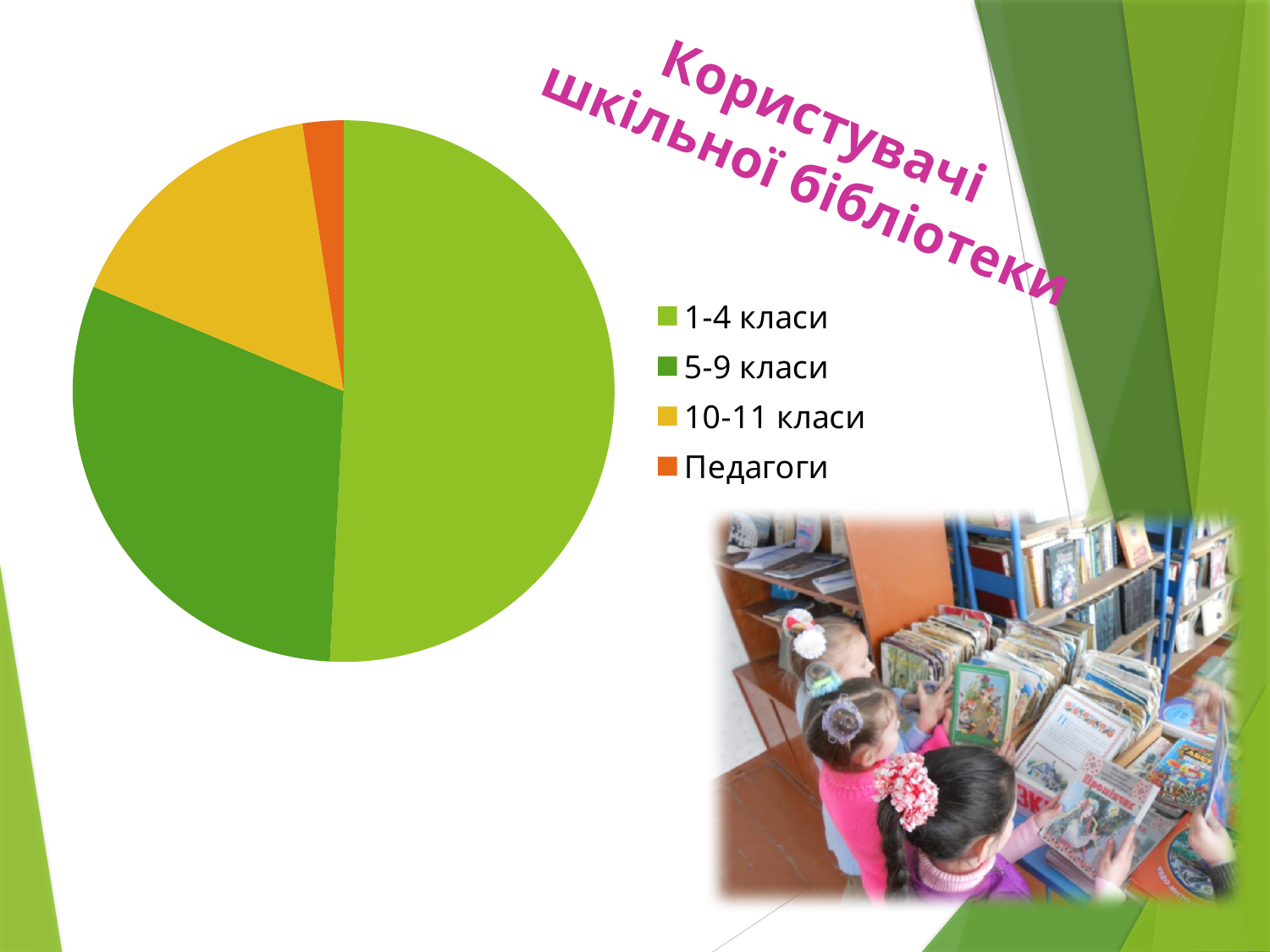
What colour is the slice for Педагоги in the pie chart? orange Which slice is larger, 1-4 класи or 5-9 класи? 1-4 класи What kind of chart is shown on the slide? pie chart Which slice is larger, 5-9 класи or 10-11 класи? 5-9 класи Which slice is larger, 10-11 класи or Педагоги? 10-11 класи What is the title of the slide with the pie chart? Користувачі шкільної бібліотеки How many slices does the pie chart have? 4 Which category has the largest slice of the pie chart? 1-4 класи Which category has the smallest slice of the pie chart? Педагоги How many entries does the legend of the pie chart list? 4